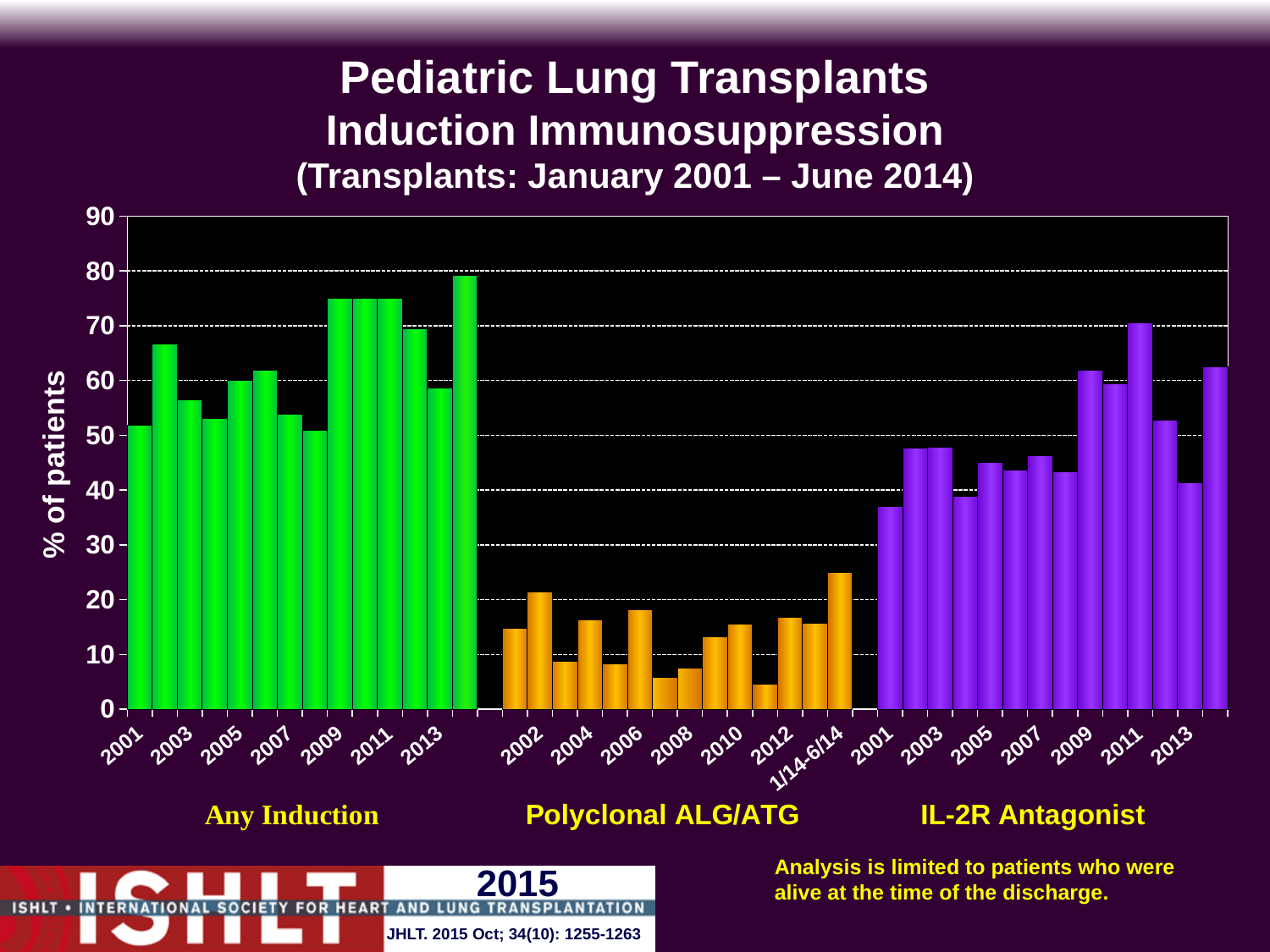
How many induction categories (groups of bars) does the chart show? 3 For 2009, which is larger: the Any Induction value or the IL-2R Antagonist value? Any Induction Is the Any Induction value for 2009 greater or less than 70? greater What kind of chart is shown on the slide? bar chart In the IL-2R Antagonist group, which year has the highest value? 2011 In the Polyclonal ALG/ATG group, which year has the lowest value? 2011 Is the Polyclonal ALG/ATG value for 2006 greater or less than 10? greater Is the IL-2R Antagonist value for 2001 greater or less than 40? less How many bars are in the Any Induction group? 14 What is the label on the vertical axis of the chart? % of patients In the Polyclonal ALG/ATG group, which period has the highest value? 1/14-6/14 For 2004, which is larger: the Polyclonal ALG/ATG value or the IL-2R Antagonist value? IL-2R Antagonist